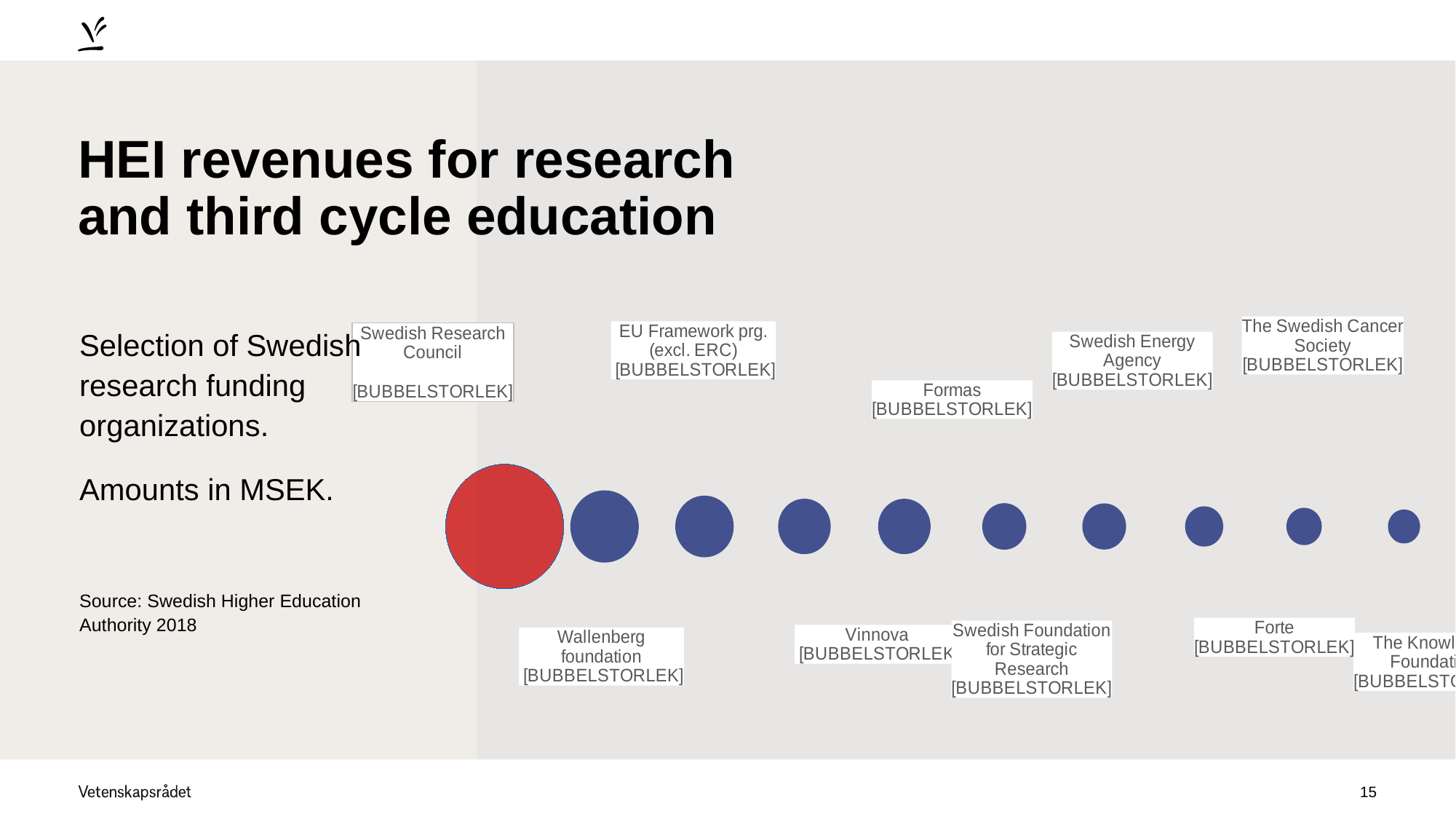
Which funding organization has the largest bubble in the chart? Swedish Research Council What colour is the bubble for the Swedish Research Council? Red Which bubble is larger, the Swedish Research Council or the Wallenberg foundation? Swedish Research Council Which bubble is larger, the EU Framework prg. (excl. ERC) or the Swedish Cancer Society? EU Framework prg. (excl. ERC) What unit are the amounts in the chart expressed in, according to the slide? MSEK How many bubbles are plotted in the chart? 11 Do the bubble sizes increase or decrease from left to right across the chart? Decrease What kind of chart is shown on the slide? Bubble chart Which bubble is larger, the Wallenberg foundation or Forte? Wallenberg foundation